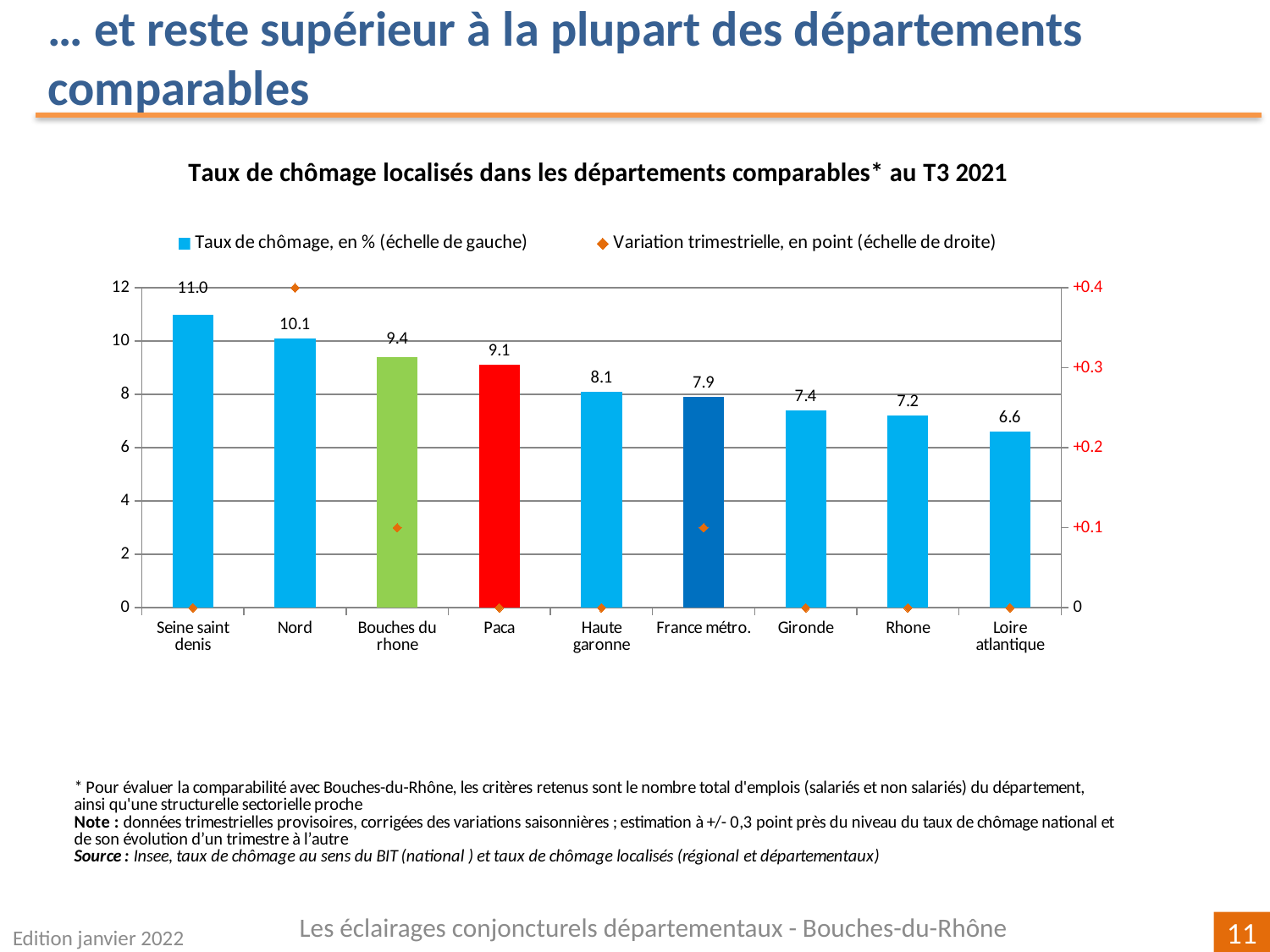
What is the quarterly variation for Bouches du rhone, read on the right axis? +0.1 Do the unemployment rate bars rise or fall from left to right along the x axis? fall What is the unemployment rate shown for Bouches du rhone? 9.4 What is the quarterly variation (Variation trimestrielle) for Nord, read on the right axis? +0.4 How many categories are shown on the x axis? 9 What is the difference between the unemployment rates of Bouches du rhone and France métro.? 1.5 Which category has the lowest unemployment rate? Loire atlantique What is the unemployment rate shown for France métro.? 7.9 Which has a higher unemployment rate, Paca or Gironde? Paca What is the unemployment rate (Taux de chômage) for Seine saint denis? 11.0 How many series does the legend list? 2 Which category has the highest unemployment rate? Seine saint denis